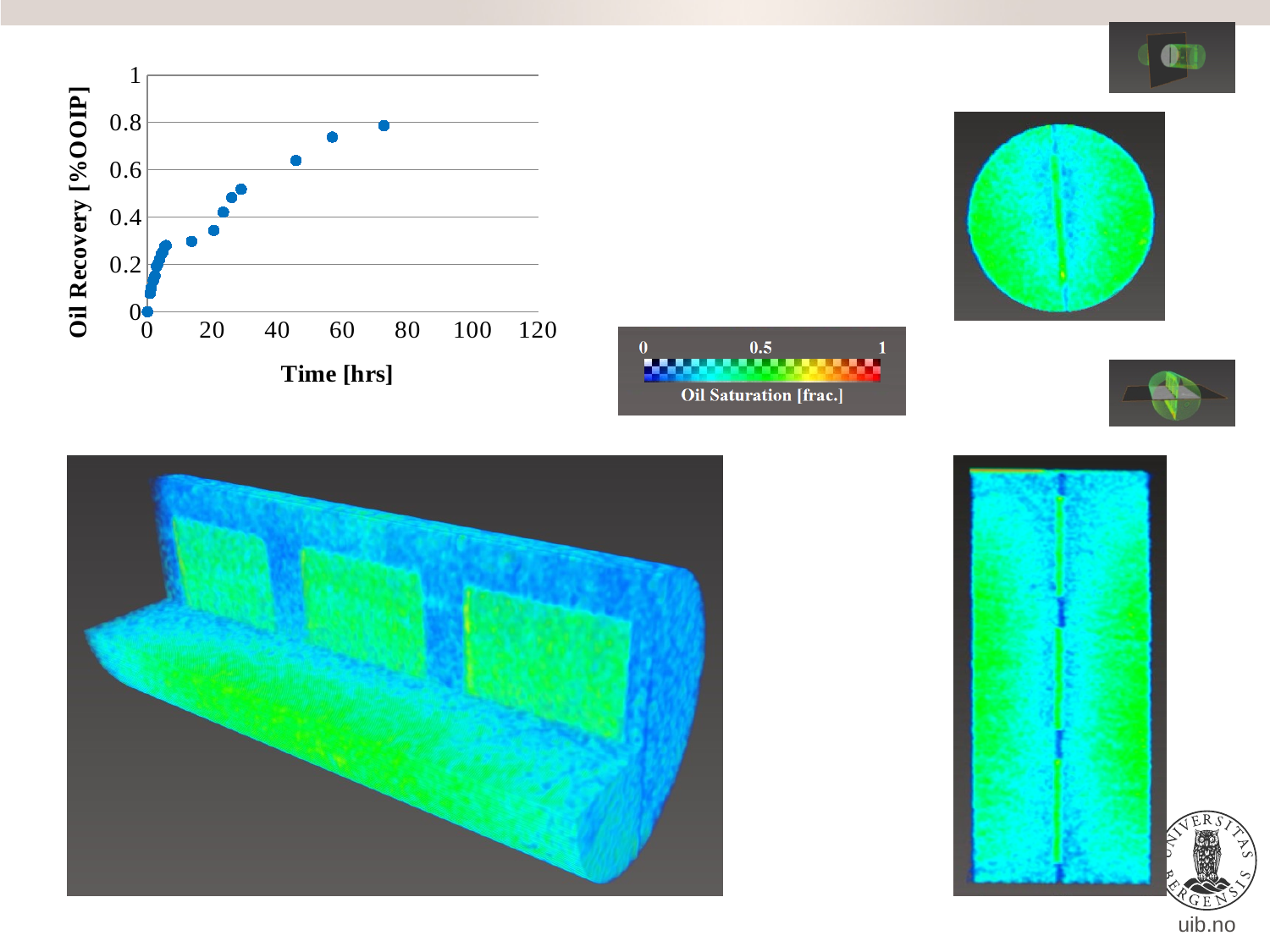
Is the oil recovery at the point near 45 hrs greater or less than 0.4? greater What is the label of the x axis? Time [hrs] Does the highest oil recovery value occur at the earliest or the latest plotted time? latest Is the oil recovery at the last plotted point (around 73 hrs) greater or less than 1? less What kind of chart is shown on the slide? scatter chart What is the label of the y axis? Oil Recovery [%OOIP] Is the oil recovery at the point near 13 hrs greater or less than 0.4? less Does oil recovery rise or fall as time increases along the x axis? rise Which is larger: the oil recovery at about 57 hrs or at about 28 hrs? about 57 hrs